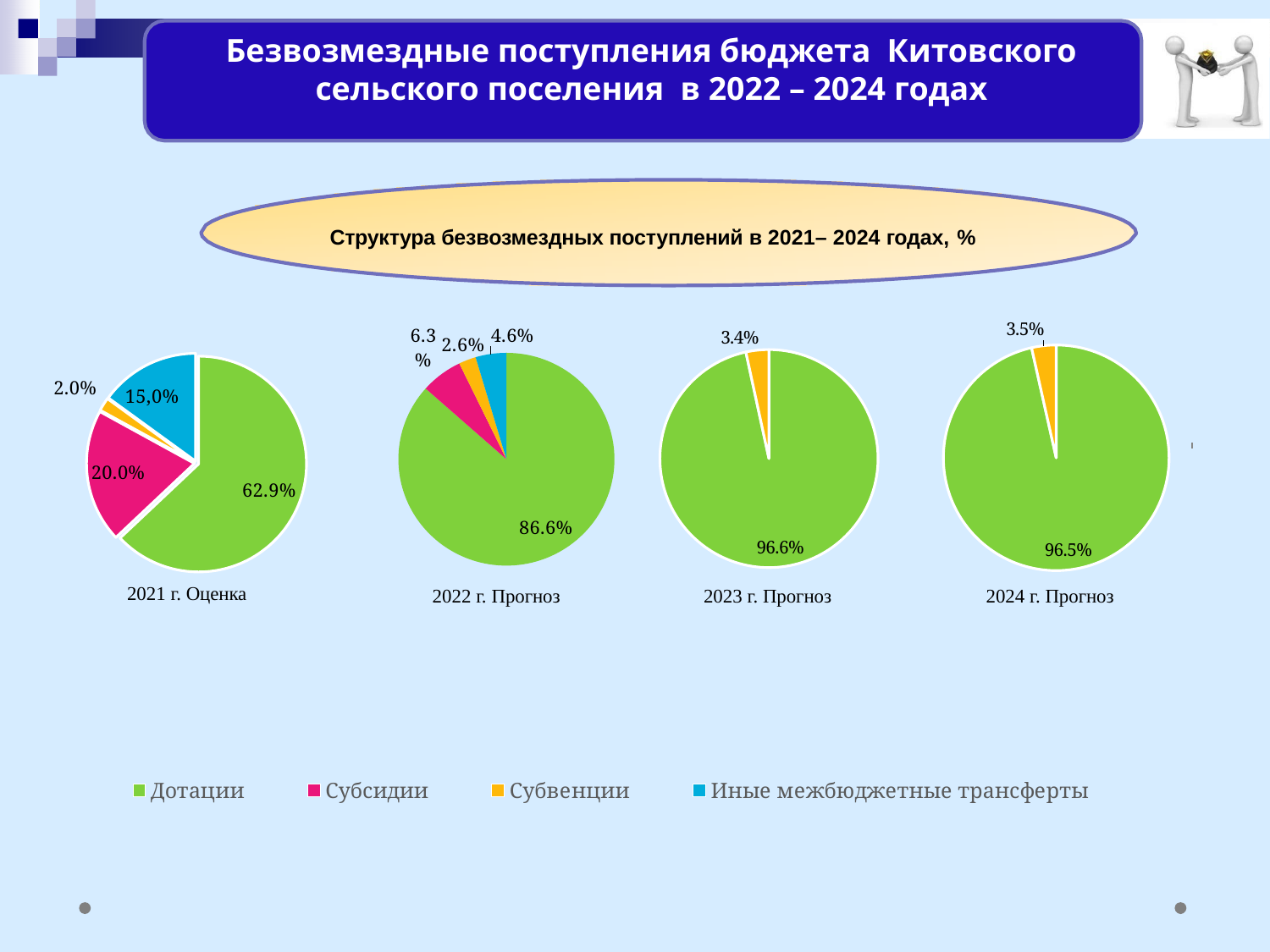
What kind of chart is used to show the structure of receipts for each year? Pie chart In the 2022 г. Прогноз pie chart, what share is shown for Дотации? 86.6% In the 2022 г. Прогноз pie chart, what is the difference between the shares of Дотации and Субсидии? 80.3% How many categories does the legend list? 4 In the 2022 г. Прогноз pie chart, which category has the largest share? Дотации In the 2024 г. Прогноз pie chart, what share is shown for Дотации? 96.5% In the 2021 г. Оценка pie chart, which category has the smallest share? Субвенции In the 2021 г. Оценка pie chart, what share is shown for Субсидии? 20.0% In the 2021 г. Оценка pie chart, what share is shown for Дотации? 62.9% In the 2021 г. Оценка pie chart, what share is shown for Иные межбюджетные трансферты? 15,0% In the 2023 г. Прогноз pie chart, what share is shown for Субвенции? 3.4% In the 2022 г. Прогноз pie chart, what share is shown for Субсидии? 6.3%